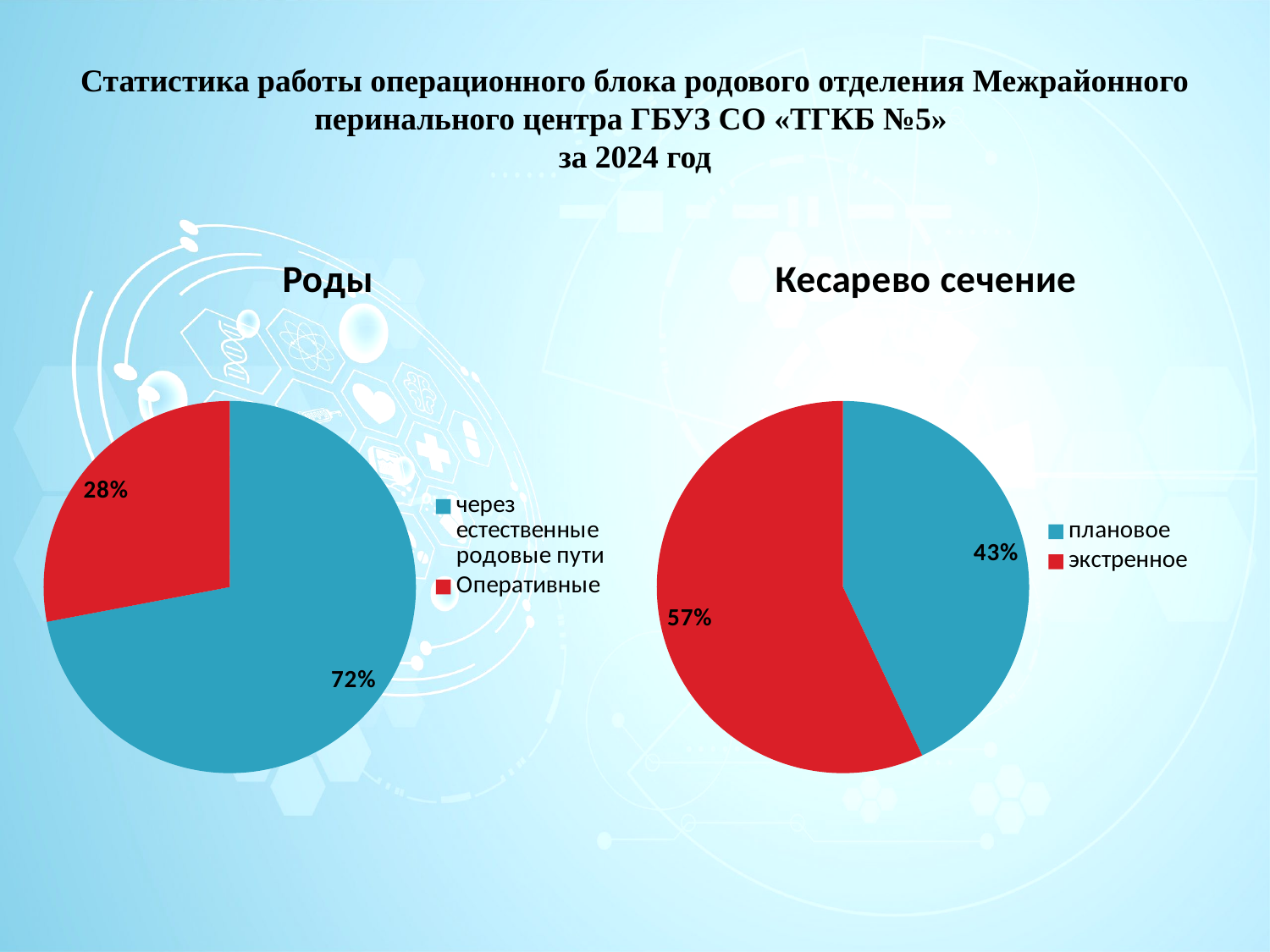
In the "Роды" chart, what share is labelled for "Оперативные"? 28% In the "Кесарево сечение" chart, what share is labelled for "плановое"? 43% In the "Роды" chart, what is the difference in percentage points between "через естественные родовые пути" and "Оперативные"? 44 In the "Кесарево сечение" chart, which is larger, "плановое" or "экстренное"? экстренное In the "Роды" chart, which category has the largest slice? через естественные родовые пути In the "Роды" chart, what colour is the "Оперативные" slice? red How many categories does the "Кесарево сечение" chart show? 2 In the "Роды" chart, what share is labelled for "через естественные родовые пути"? 72% In the "Кесарево сечение" chart, which category has the smallest slice? плановое What type of chart is the "Роды" chart? pie chart In the "Кесарево сечение" chart, what share is labelled for "экстренное"? 57% In the "Кесарево сечение" chart, what is the difference in percentage points between "экстренное" and "плановое"? 14